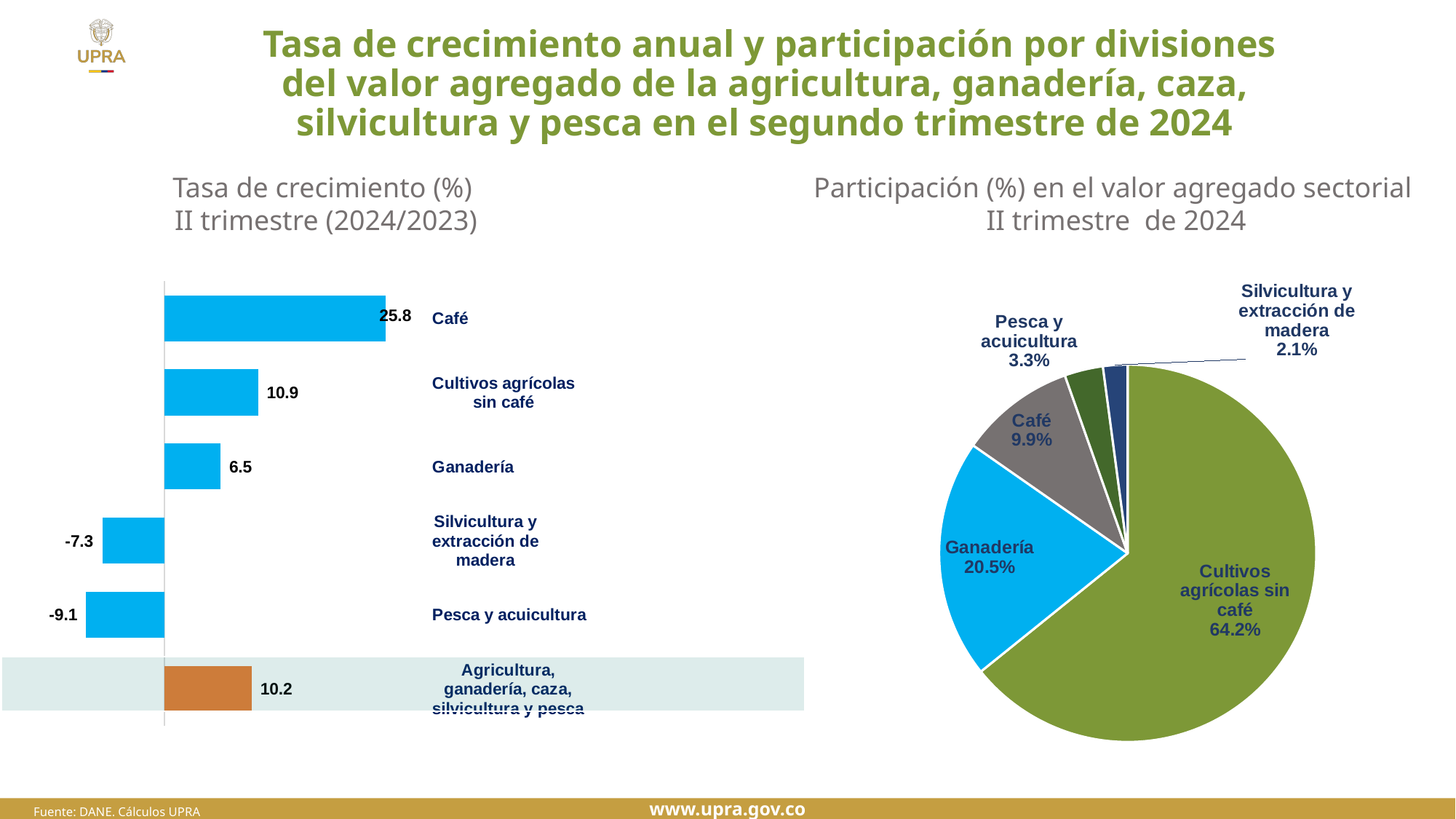
In the 'Tasa de crecimiento (%) II trimestre (2024/2023)' bar chart, what is the value for Pesca y acuicultura? -9.1 In the 'Tasa de crecimiento (%) II trimestre (2024/2023)' bar chart, what is the difference between the values for Café and Cultivos agrícolas sin café? 14.9 In the 'Tasa de crecimiento (%) II trimestre (2024/2023)' bar chart, which category has the highest growth rate? Café In the 'Tasa de crecimiento (%) II trimestre (2024/2023)' bar chart, which is larger: the value for Ganadería or the value for Cultivos agrícolas sin café? Cultivos agrícolas sin café In the 'Participación (%) en el valor agregado sectorial II trimestre de 2024' pie chart, what is the difference between the shares of Cultivos agrícolas sin café and Café? 54.3% In the 'Participación (%) en el valor agregado sectorial II trimestre de 2024' pie chart, what share does Ganadería have? 20.5% In the 'Participación (%) en el valor agregado sectorial II trimestre de 2024' pie chart, which slice is the smallest? Silvicultura y extracción de madera In the 'Tasa de crecimiento (%) II trimestre (2024/2023)' bar chart, what is the growth rate for Café? 25.8 In the 'Tasa de crecimiento (%) II trimestre (2024/2023)' bar chart, which bar is coloured orange instead of blue? Agricultura, ganadería, caza, silvicultura y pesca In the 'Tasa de crecimiento (%) II trimestre (2024/2023)' bar chart, which category has the lowest value? Pesca y acuicultura What type of chart is the 'Tasa de crecimiento (%) II trimestre (2024/2023)' chart on the left? Bar chart How many categories are shown in the 'Tasa de crecimiento (%) II trimestre (2024/2023)' bar chart? 6